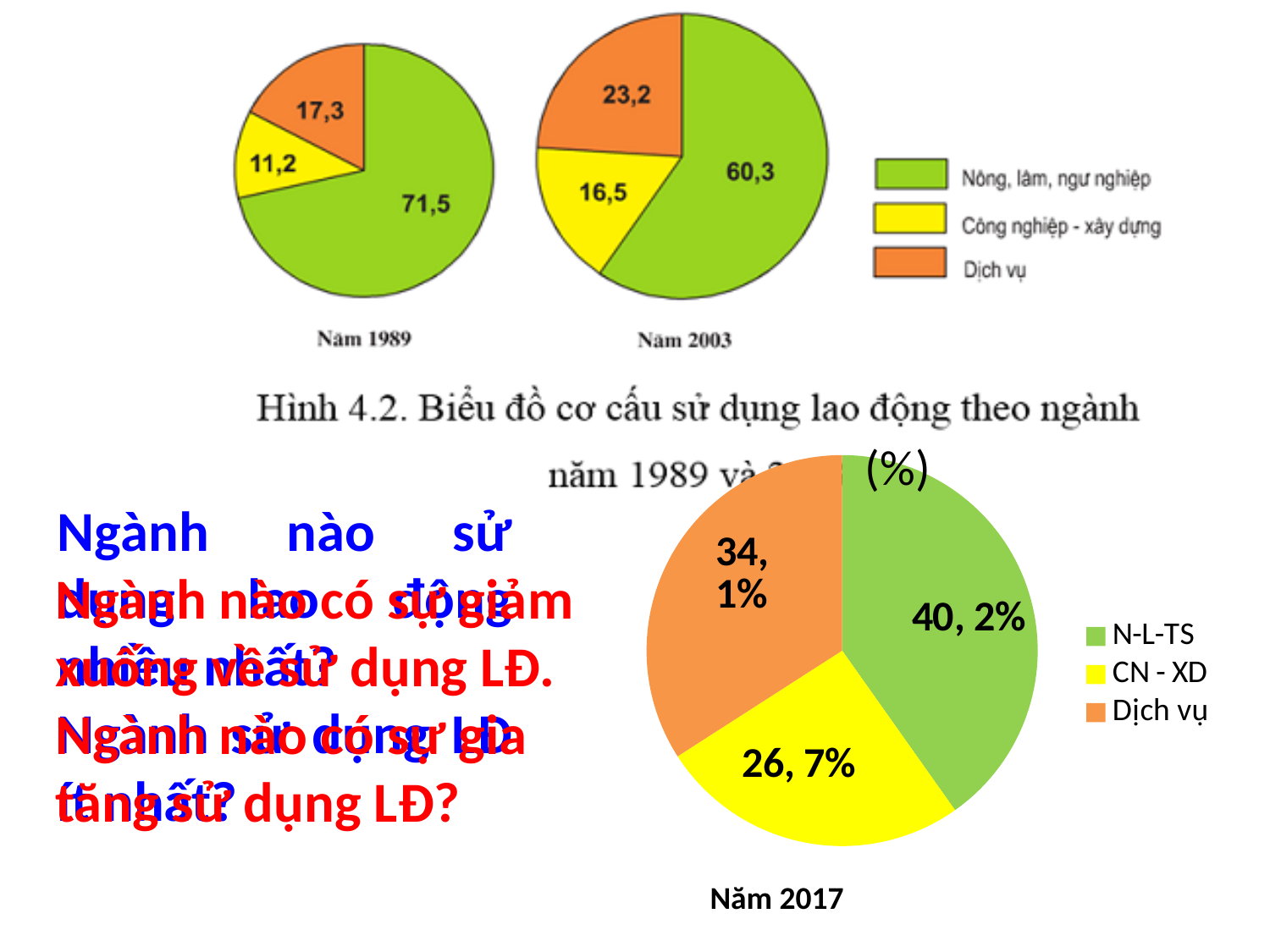
In the Năm 1989 pie chart, what is the value for Công nghiệp - xây dựng? 11,2 In the Năm 2017 pie chart, which category has the smallest share? CN - XD In the Năm 2017 pie chart, which is larger: Dịch vụ or CN - XD? Dịch vụ What is the difference between the Nông, lâm, ngư nghiệp value in the Năm 1989 chart and in the Năm 2003 chart? 11,2 In the Năm 2017 pie chart, what is the value shown for CN - XD? 26, 7% How many categories does the legend of the Năm 2017 pie chart list? 3 What type of chart is the Năm 2017 chart? Pie chart In the Năm 1989 pie chart, what is the value for Nông, lâm, ngư nghiệp? 71,5 In the Năm 2003 pie chart, what is the value for Dịch vụ? 23,2 In the Năm 1989 pie chart, which sector has the smallest share? Công nghiệp - xây dựng In the Năm 2017 pie chart, what is the value shown for N-L-TS? 40, 2% In the Năm 2003 pie chart, which sector has the largest share? Nông, lâm, ngư nghiệp